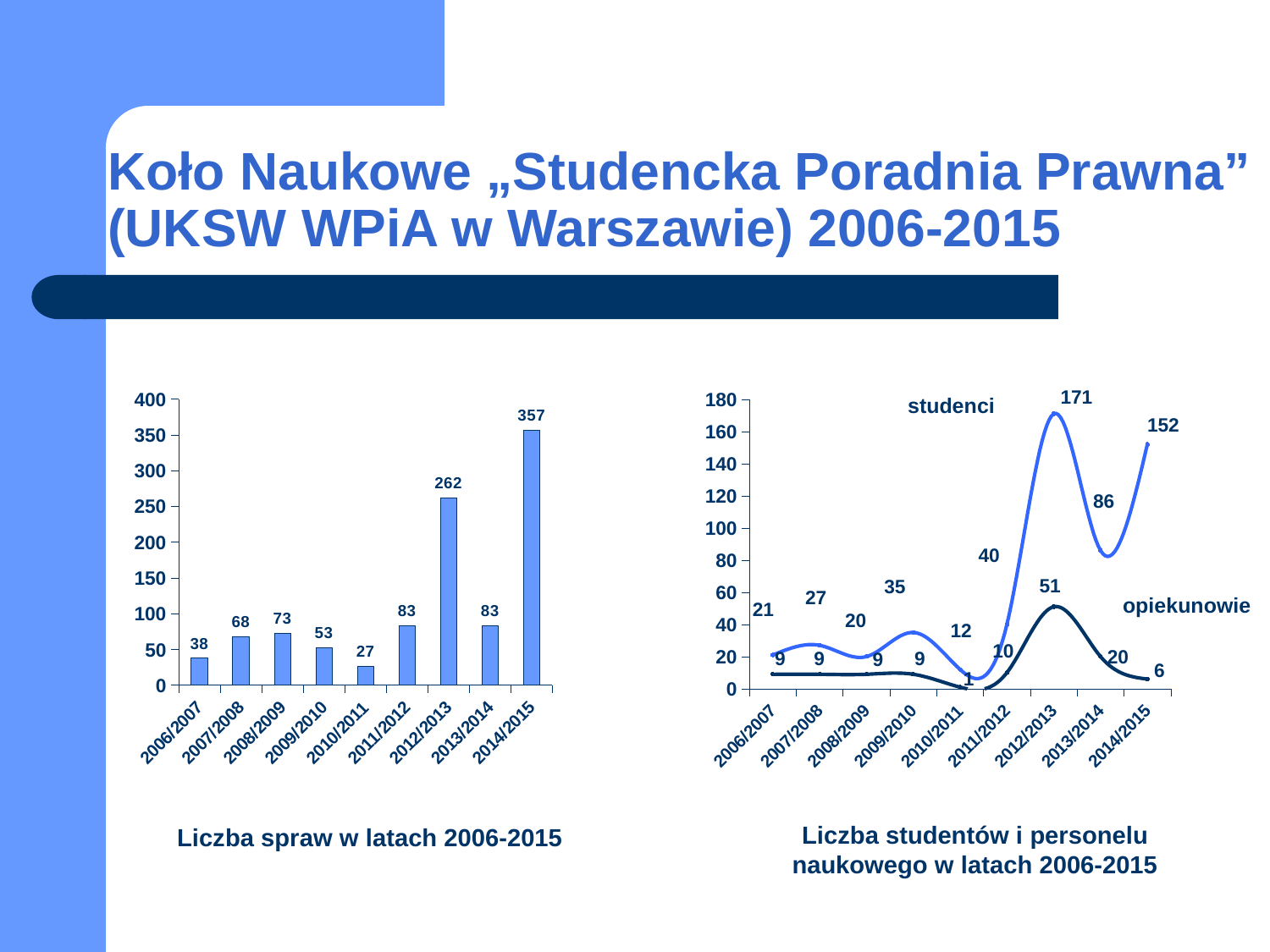
What kind of chart is the one titled "Liczba spraw w latach 2006-2015"? Bar chart In the chart titled "Liczba studentów i personelu naukowego w latach 2006-2015", what is the value for studenci in 2012/2013? 171 In the chart titled "Liczba spraw w latach 2006-2015", how many years are shown on the x axis? 9 In the chart titled "Liczba spraw w latach 2006-2015", which year has the highest value? 2014/2015 What kind of chart is the one titled "Liczba studentów i personelu naukowego w latach 2006-2015"? Line chart In the chart titled "Liczba studentów i personelu naukowego w latach 2006-2015", what is the difference between studenci and opiekunowie in 2012/2013? 120 In the chart titled "Liczba studentów i personelu naukowego w latach 2006-2015", in which year is the opiekunowie value lowest? 2010/2011 In the chart titled "Liczba spraw w latach 2006-2015", which year has the lowest value? 2010/2011 In the chart titled "Liczba studentów i personelu naukowego w latach 2006-2015", what is the value for opiekunowie in 2014/2015? 6 In the chart titled "Liczba studentów i personelu naukowego w latach 2006-2015", which is larger in 2013/2014: studenci or opiekunowie? studenci In the chart titled "Liczba spraw w latach 2006-2015", what is the value for 2012/2013? 262 In the chart titled "Liczba spraw w latach 2006-2015", what is the difference between the values for 2014/2015 and 2012/2013? 95